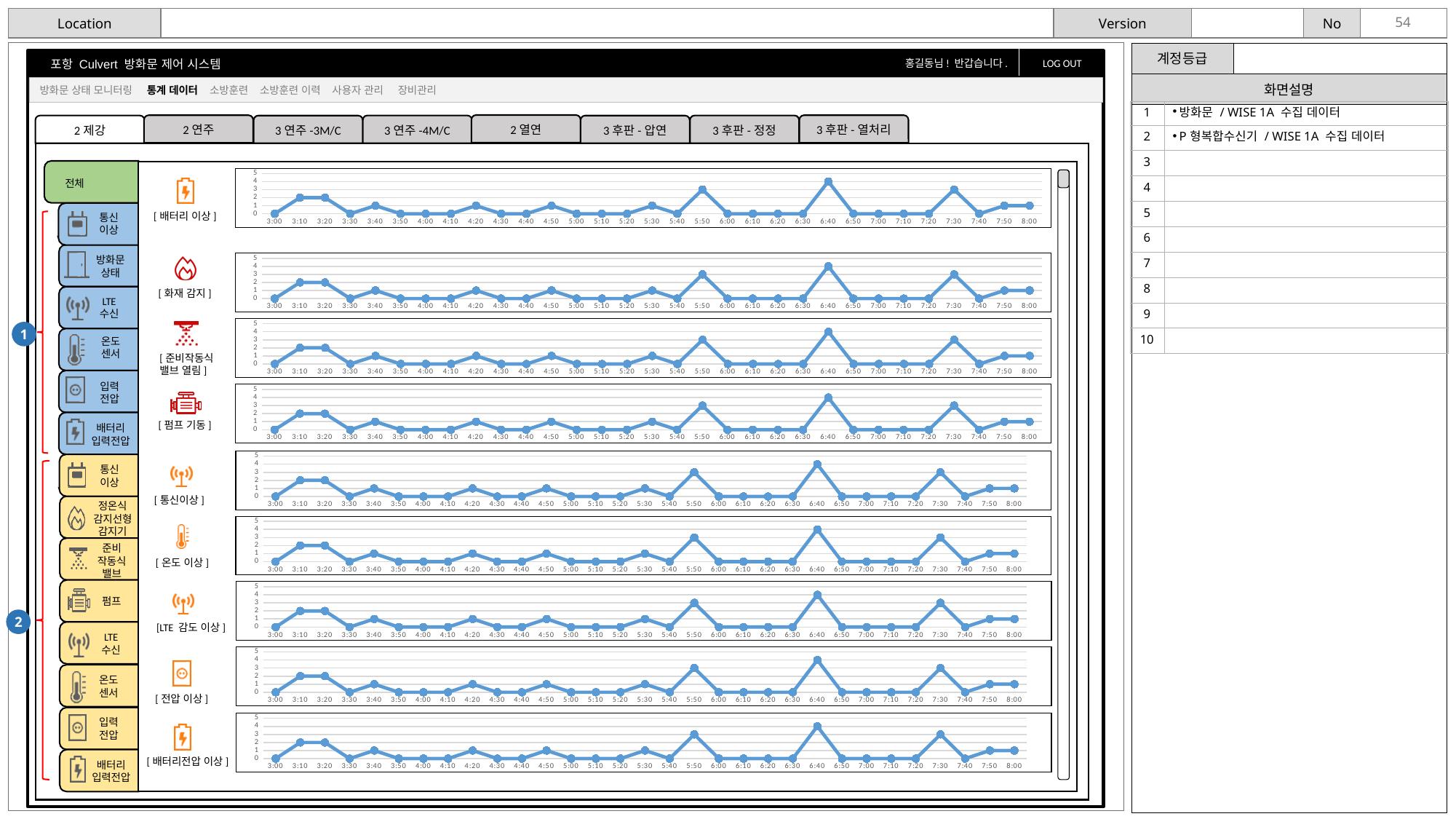
In the [배터리 이상] chart, how many time points are on the x axis from 3:00 to 8:00? 31 In the [배터리전압 이상] chart, do the values rise or fall from 6:40 to 6:50? fall What is the label of the last (bottom) chart on the slide? [ 배터리전압 이상 ] In the [온도 이상] chart, which is larger, the value at 5:50 or the value at 6:40? 6:40 What is the label of the first (top) chart on the slide? [ 배터리 이상 ] In the [펌프 기동] chart, is the value at 6:40 greater or less than 3? greater In the [화재 감지] chart, at which time is the value highest? 6:40 What kind of chart is the [배터리 이상] chart? line chart In the [통신이상] chart, is the value at 3:00 greater or less than 1? less How many line charts are shown on the slide? 9 In the [LTE 감도 이상] chart, which is larger, the value at 3:10 or the value at 3:30? 3:10 In the [전압 이상] chart, what is the value at 3:00? 0